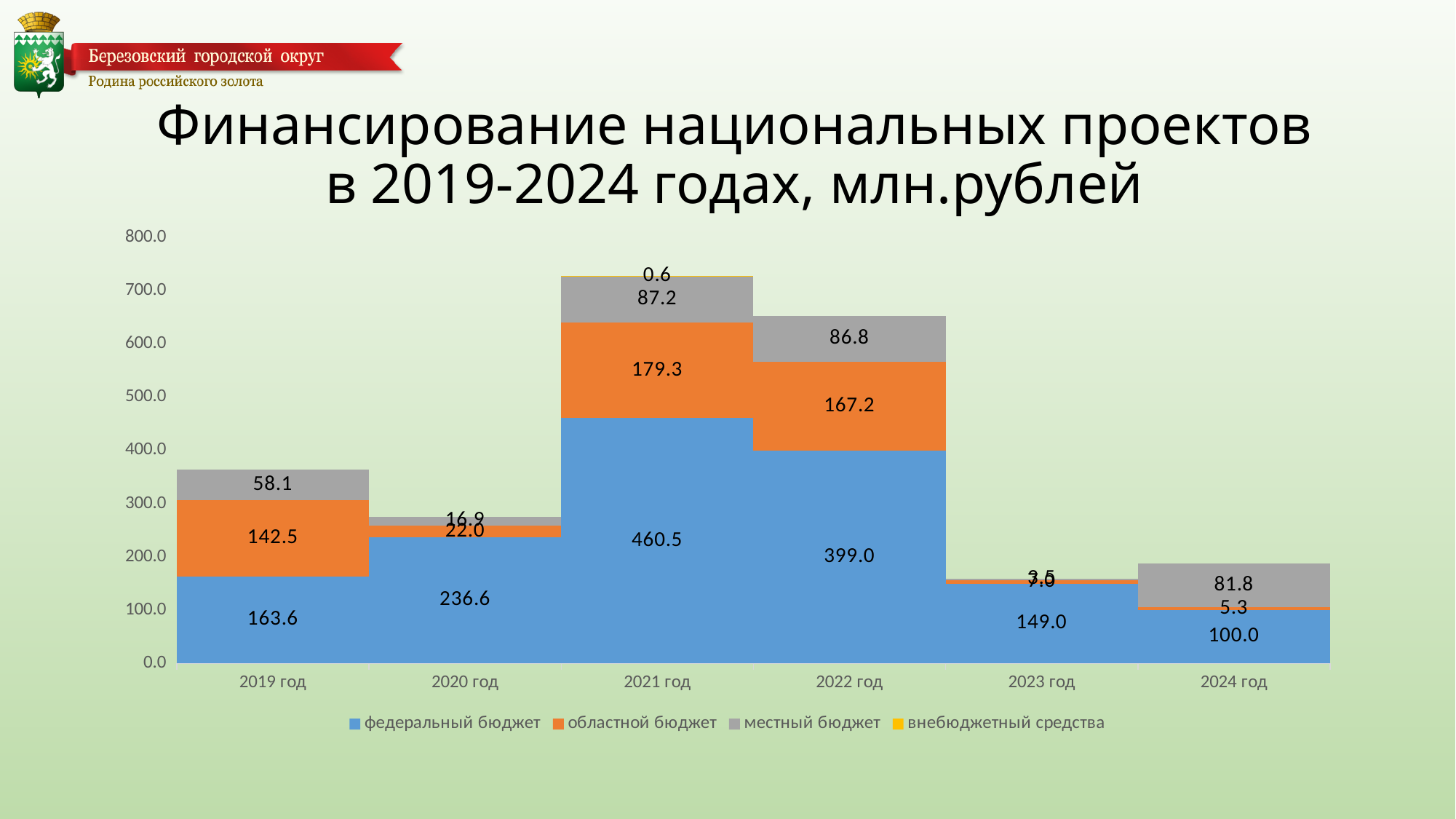
Which is larger: областной бюджет in 2020 год or областной бюджет in 2024 год? 2020 год Is the total of the stacked bar for 2021 год greater or less than 700.0? greater What kind of chart is shown on the slide? stacked bar chart In which year is the федеральный бюджет value the highest? 2021 год In which year is the федеральный бюджет value the lowest? 2024 год How many years (categories) are shown on the x axis? 6 How many series does the legend list? 4 What is the difference between the федеральный бюджет values for 2021 год and 2022 год? 61.5 What is the value of местный бюджет for 2024 год? 81.8 What is the total of the stacked bar for 2022 год? 653.0 What is the value of областной бюджет for 2019 год? 142.5 What is the value of федеральный бюджет for 2021 год? 460.5